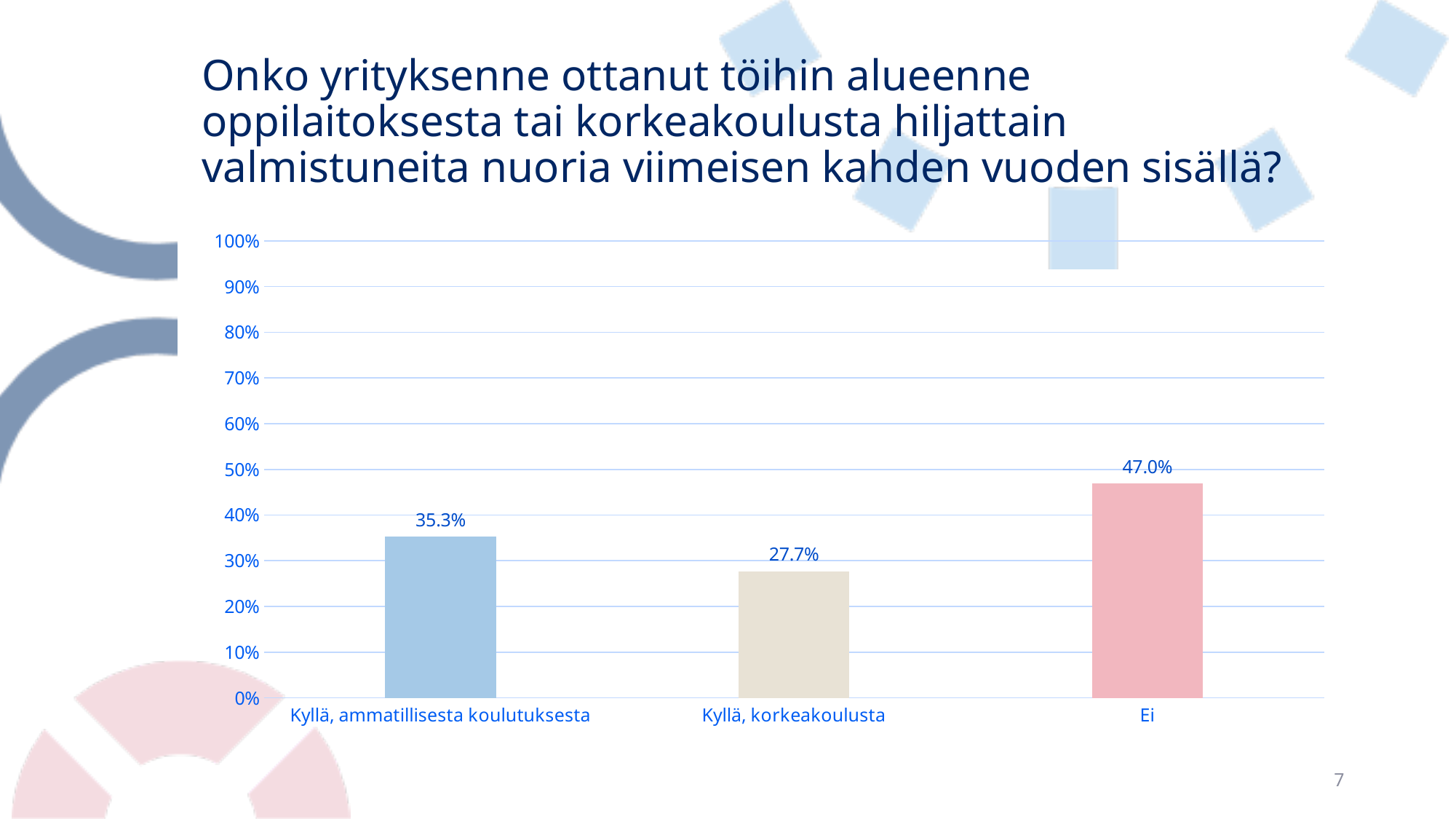
What is the difference between the values for "Kyllä, ammatillisesta koulutuksesta" and "Kyllä, korkeakoulusta"? 7.6% What is the difference between the values for "Ei" and "Kyllä, ammatillisesta koulutuksesta"? 11.7% Which is larger, the value for "Kyllä, korkeakoulusta" or the value for "Ei"? Ei How many categories are shown on the x axis? 3 What is the value for "Kyllä, korkeakoulusta"? 27.7% What is the value for "Kyllä, ammatillisesta koulutuksesta"? 35.3% What is the highest value shown on the y axis? 100% What is the value for "Ei"? 47.0% Which category has the highest value? Ei Which category has the lowest value? Kyllä, korkeakoulusta What kind of chart is shown on the slide? bar chart Is the value for "Ei" greater or less than 50%? less